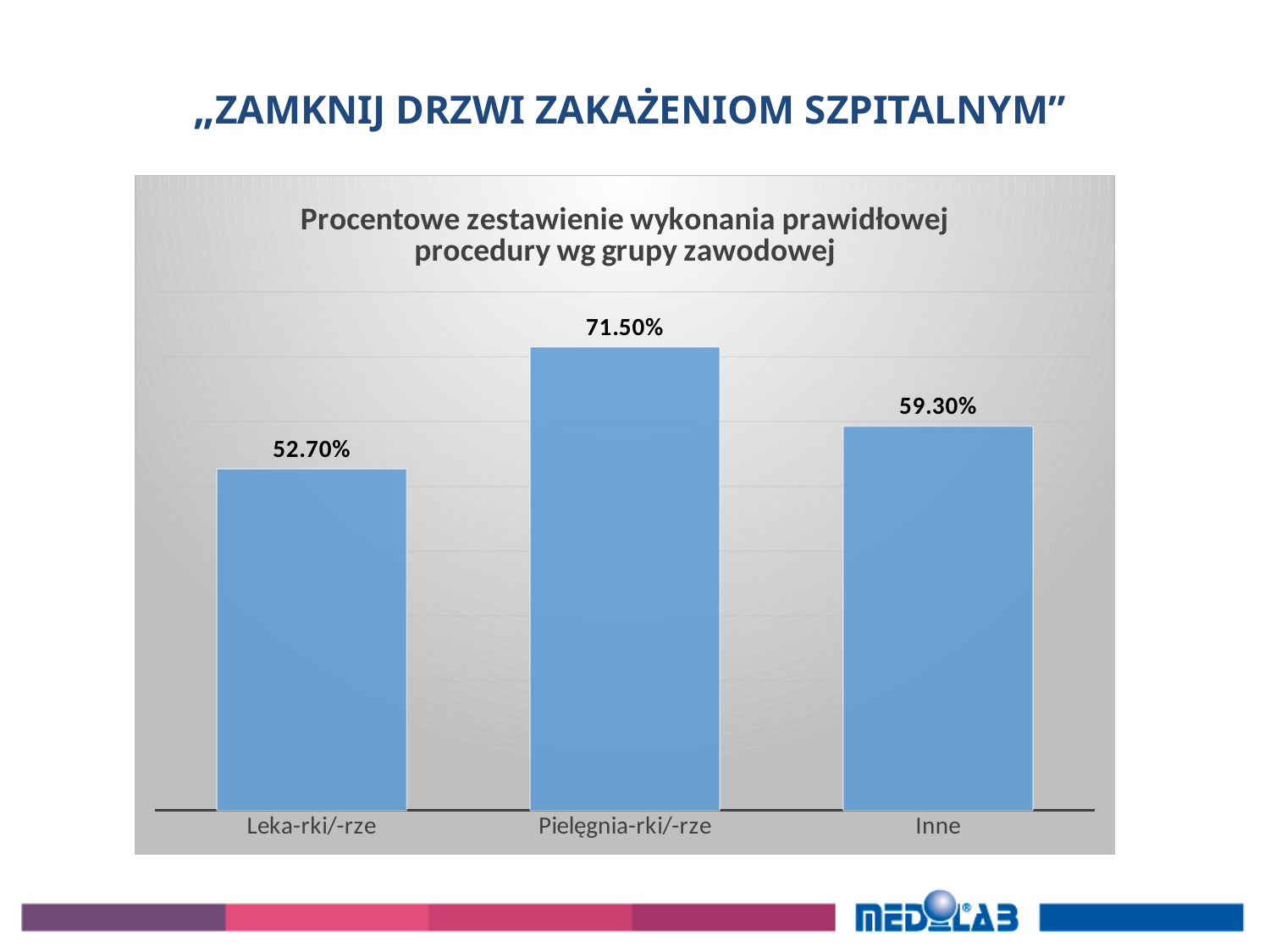
What is the title of the chart? Procentowe zestawienie wykonania prawidłowej procedury wg grupy zawodowej Which is larger, the value for Inne or the value for Leka-rki/-rze? Inne What is the difference between the values for Inne and Leka-rki/-rze? 6.60% What is the difference between the values for Pielęgnia-rki/-rze and Leka-rki/-rze? 18.80% What colour are the bars in the chart? Blue What kind of chart is shown on the slide? Bar chart Which category has the highest value? Pielęgnia-rki/-rze Which category has the lowest value? Leka-rki/-rze How many categories are shown in the chart? 3 What is the value for Leka-rki/-rze? 52.70% What is the value for Inne? 59.30% What is the value for Pielęgnia-rki/-rze? 71.50%